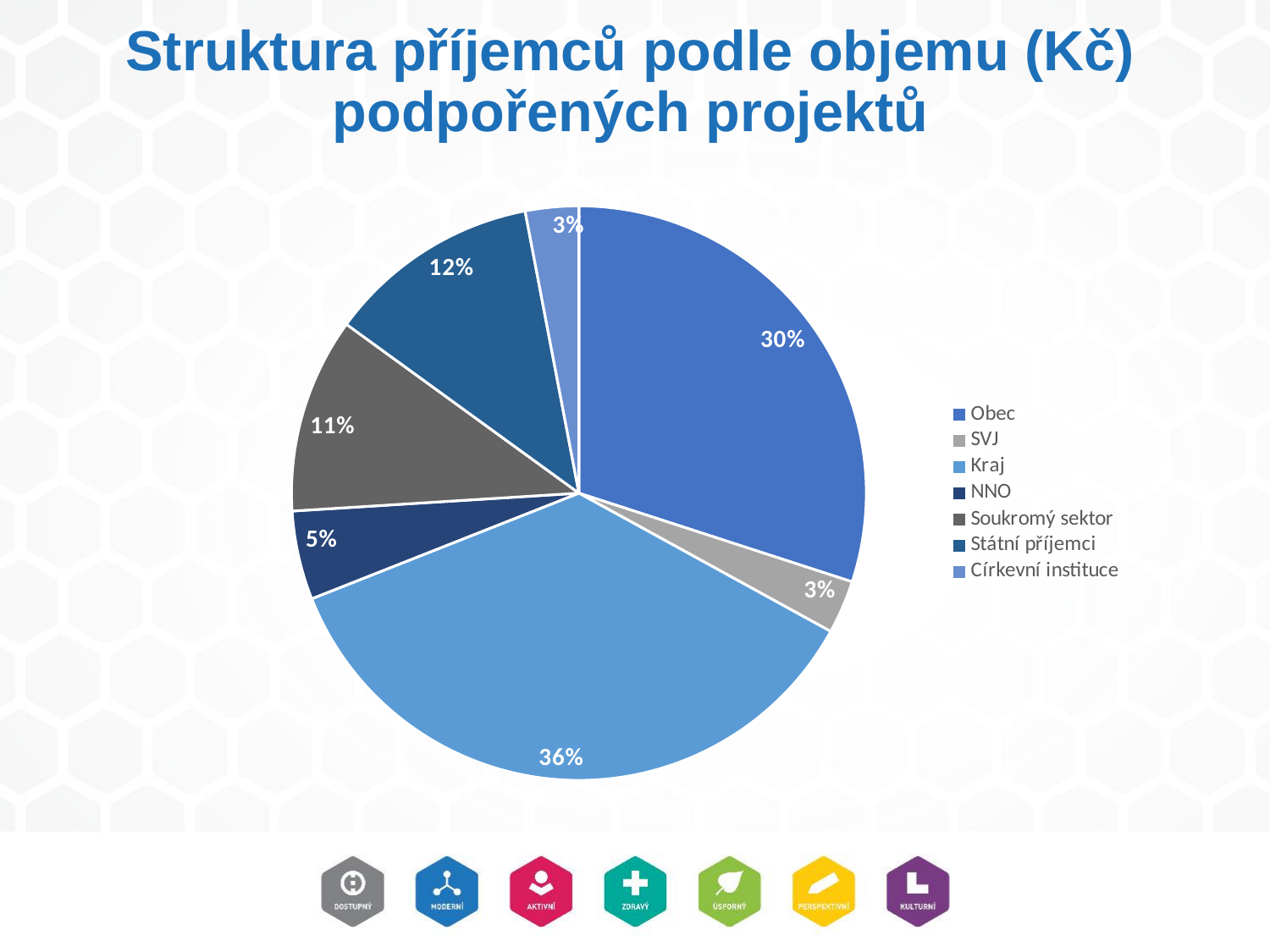
What share of the pie does Státní příjemci have? 12% Which category has the larger share, Státní příjemci or NNO? Státní příjemci What share of the pie does Obec have? 30% What is the difference in percentage points between the shares of Kraj and Obec? 6 What is the title of the chart? Struktura příjemců podle objemu (Kč) podpořených projektů Which category has the largest share of the pie? Kraj How many categories does the legend list? 7 Which category has the larger share, Obec or Kraj? Kraj What share of the pie does Soukromý sektor have? 11% What kind of chart is shown on the slide? pie chart